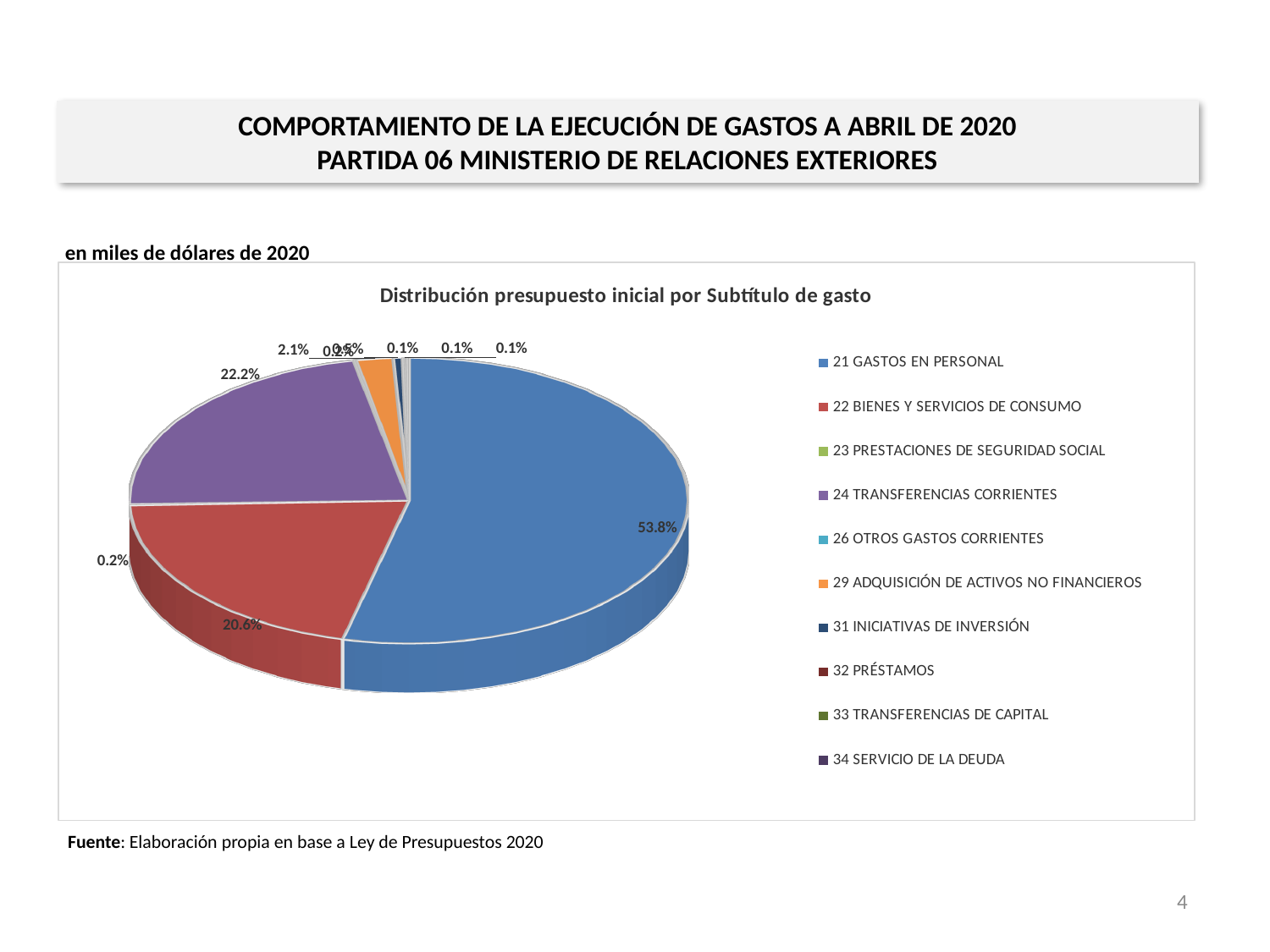
What is the difference in percentage points between the shares of 21 GASTOS EN PERSONAL and 22 BIENES Y SERVICIOS DE CONSUMO? 33.2 percentage points How many categories does the chart legend list? 10 What type of chart is shown on the slide? Pie chart What share of the pie does 21 GASTOS EN PERSONAL represent? 53.8% Which slice is larger: 22 BIENES Y SERVICIOS DE CONSUMO or 24 TRANSFERENCIAS CORRIENTES? 24 TRANSFERENCIAS CORRIENTES What colour is the slice for 21 GASTOS EN PERSONAL? Blue What share of the pie does 24 TRANSFERENCIAS CORRIENTES represent? 22.2% What is the title of the chart? Distribución presupuesto inicial por Subtítulo de gasto Which category has the largest slice of the pie? 21 GASTOS EN PERSONAL What share of the pie does 22 BIENES Y SERVICIOS DE CONSUMO represent? 20.6% What is the difference in percentage points between the shares of 24 TRANSFERENCIAS CORRIENTES and 22 BIENES Y SERVICIOS DE CONSUMO? 1.6 percentage points Is the share for 21 GASTOS EN PERSONAL greater or less than 50%? greater